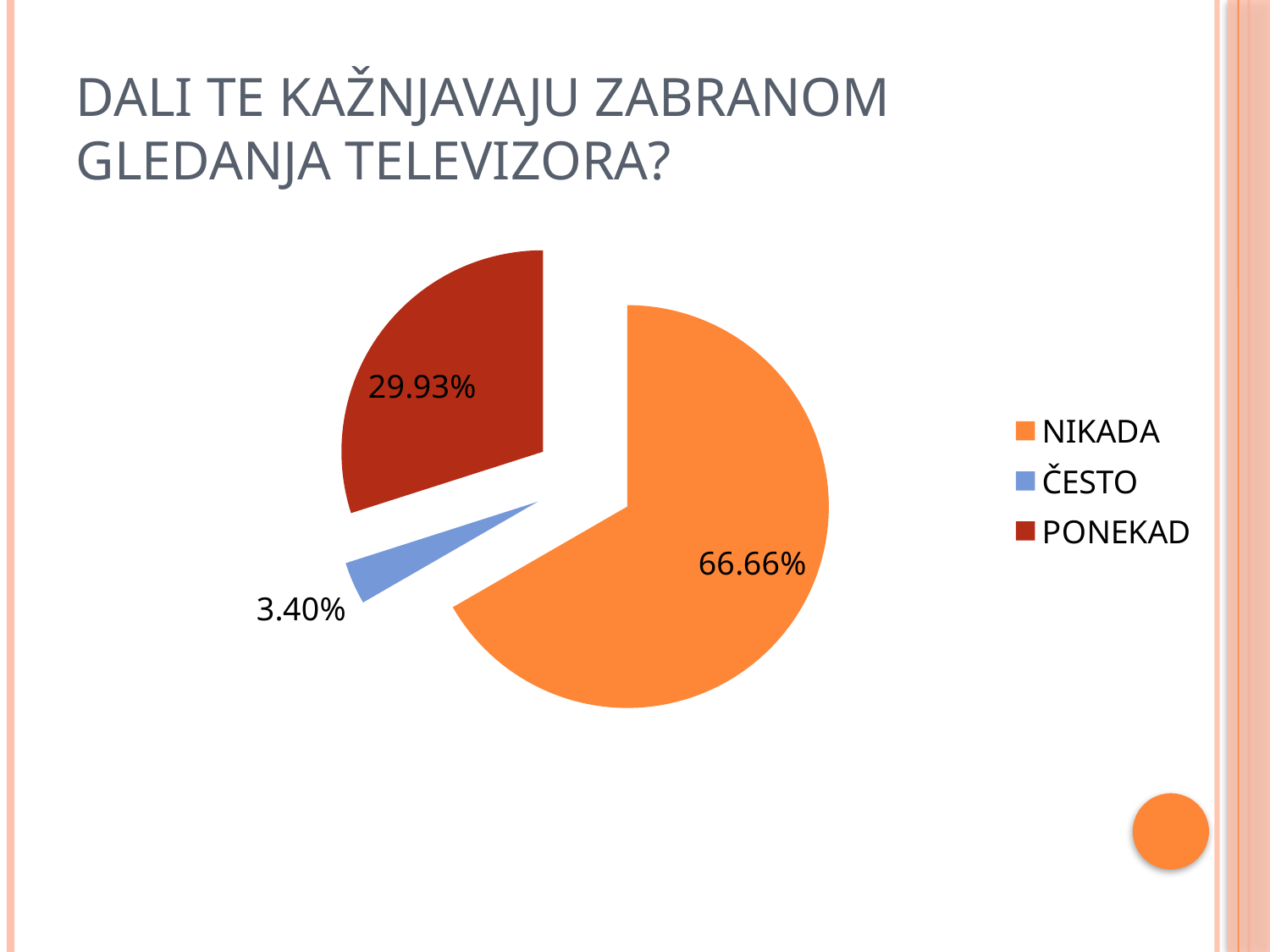
Which is larger, the share for PONEKAD or the share for ČESTO? PONEKAD Which category has the largest slice of the pie? NIKADA What colour is the slice for ČESTO? blue What percentage is shown for NIKADA? 66.66% What type of chart is shown on the slide? pie chart What is the difference in percentage points between NIKADA and PONEKAD? 36.73 Which category has the smallest slice of the pie? ČESTO How many entries does the legend list? 3 What percentage is shown for ČESTO? 3.40% What percentage is shown for PONEKAD? 29.93% What is the title of the slide containing the chart? DALI TE KAŽNJAVAJU ZABRANOM GLEDANJA TELEVIZORA? How many slices does the pie chart have? 3